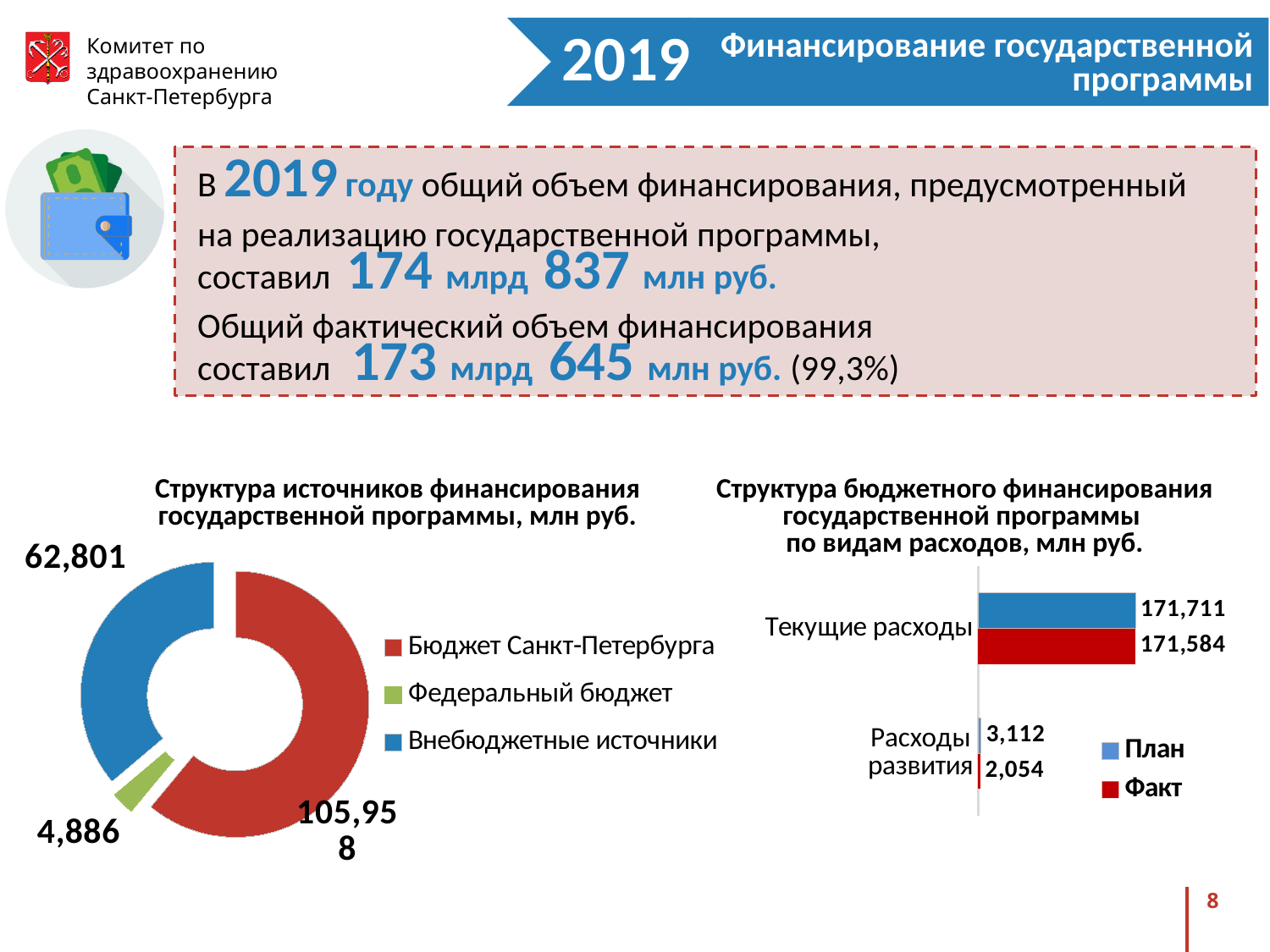
How many categories does the legend of the chart 'Структура источников финансирования государственной программы, млн руб.' list? 3 In the chart 'Структура бюджетного финансирования государственной программы по видам расходов, млн руб.', what is the План value for Текущие расходы? 171,711 In the chart 'Структура источников финансирования государственной программы, млн руб.', what is the value for Бюджет Санкт-Петербурга? 105,958 How many series does the legend of the chart 'Структура бюджетного финансирования государственной программы по видам расходов, млн руб.' list? 2 In the chart 'Структура бюджетного финансирования государственной программы по видам расходов, млн руб.', what is the difference between План and Факт for Текущие расходы? 127 In the chart 'Структура бюджетного финансирования государственной программы по видам расходов, млн руб.', what is the Факт value for Расходы развития? 2,054 In the chart 'Структура источников финансирования государственной программы, млн руб.', what is the value for Федеральный бюджет? 4,886 In the chart 'Структура бюджетного финансирования государственной программы по видам расходов, млн руб.', which is larger for Расходы развития: План or Факт? План What kind of chart is 'Структура источников финансирования государственной программы, млн руб.'? Doughnut chart In the chart 'Структура источников финансирования государственной программы, млн руб.', which source has the largest value? Бюджет Санкт-Петербурга In the chart 'Структура источников финансирования государственной программы, млн руб.', which source has the smallest value? Федеральный бюджет In the chart 'Структура источников финансирования государственной программы, млн руб.', what is the difference between Внебюджетные источники and Федеральный бюджет? 57,915